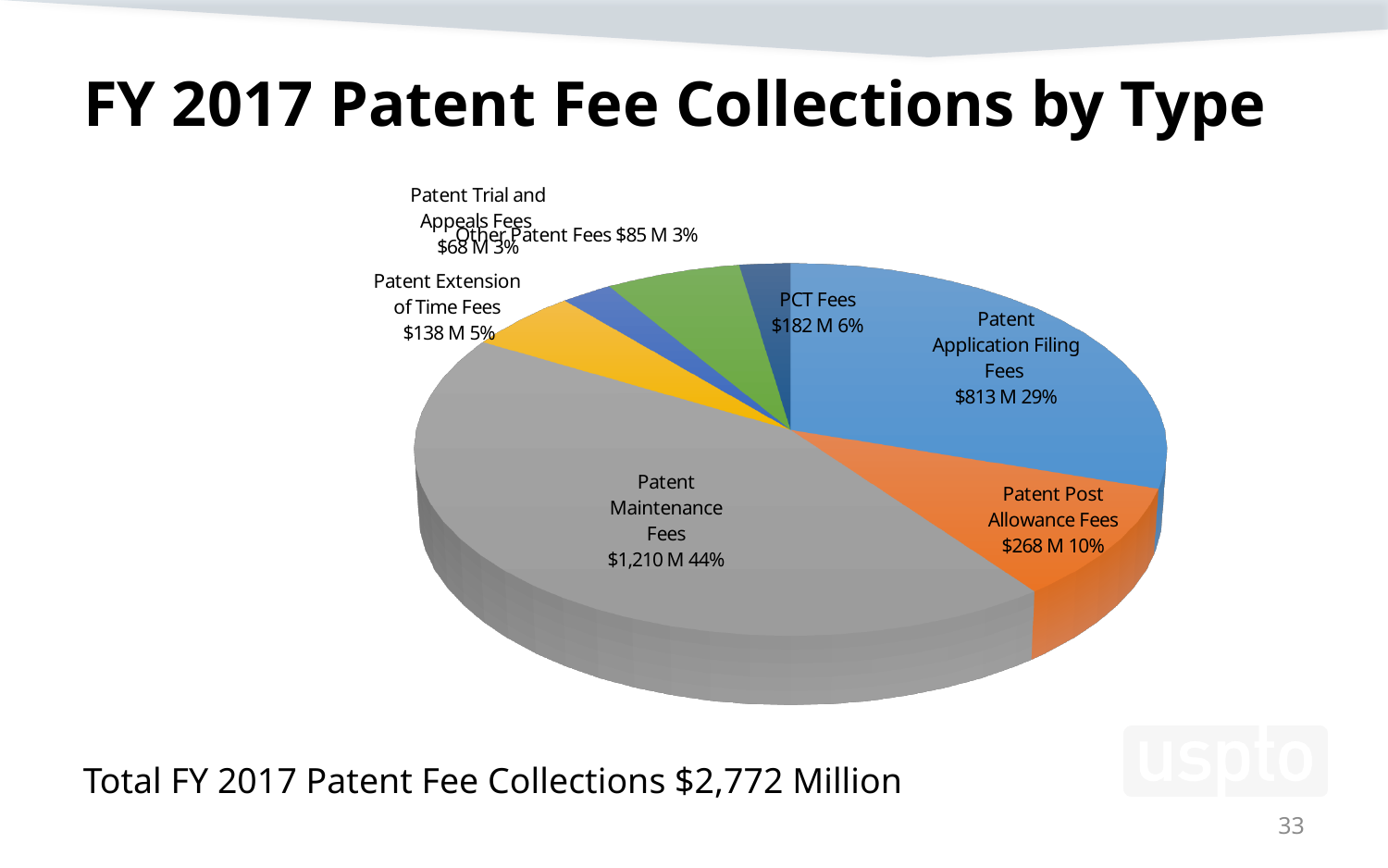
Which fee type has the smallest dollar value in the pie? Patent Trial and Appeals Fees What is the title of the chart on the slide? FY 2017 Patent Fee Collections by Type What is the value for Patent Maintenance Fees? $1,210 M Which fee type has the largest slice of the pie? Patent Maintenance Fees What is the difference between Patent Application Filing Fees and Patent Post Allowance Fees? $545 M What kind of chart is shown on the slide? pie chart What is the value for PCT Fees? $182 M What share of the pie do Patent Application Filing Fees represent? 29% What is the difference between Patent Maintenance Fees and Patent Application Filing Fees? $397 M How many fee types are shown in the pie chart? 7 Which is larger, PCT Fees or Patent Extension of Time Fees? PCT Fees What share of the pie do Patent Post Allowance Fees represent? 10%